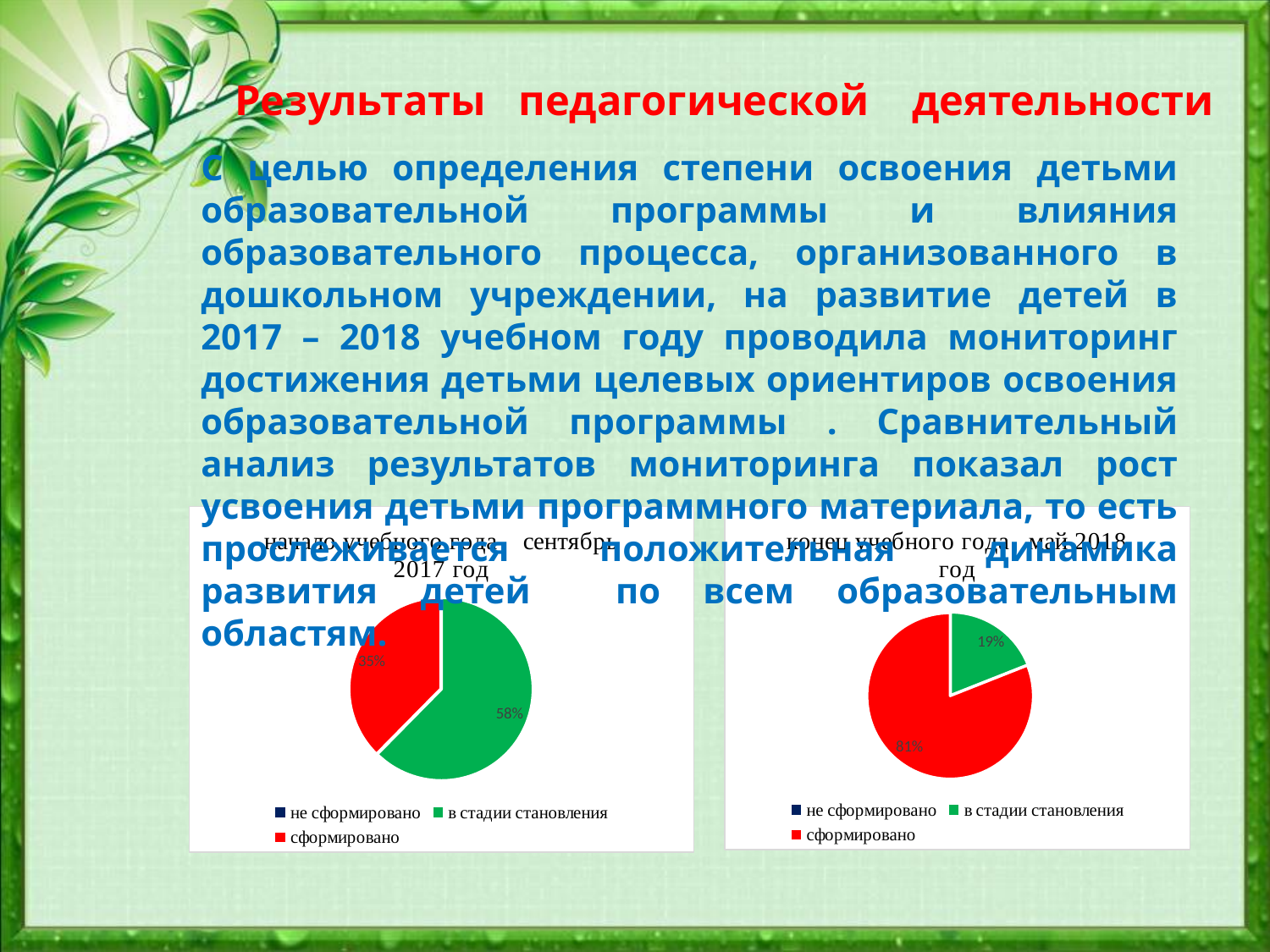
In the left pie chart (начало учебного года сентябрь 2017 год), which category has the largest slice? в стадии становления In the left pie chart (начало учебного года сентябрь 2017 год), what is the value for в стадии становления? 58% In the right pie chart (конец учебного года май 2018 год), what share of the pie is в стадии становления? 19% In the left pie chart (начало учебного года сентябрь 2017 год), what is the difference between в стадии становления and сформировано? 23 percentage points In the right pie chart (конец учебного года май 2018 год), what is the value for сформировано? 81% In the right pie chart (конец учебного года май 2018 год), which category has the largest slice? сформировано What kind of charts are shown on the slide? Pie charts How many entries does the legend of the right pie chart (конец учебного года май 2018 год) list? 3 In the left pie chart (начало учебного года сентябрь 2017 год), what is the value for сформировано? 35% In the right pie chart (конец учебного года май 2018 год), what colour represents сформировано? Red In the right pie chart (конец учебного года май 2018 год), what is the difference between сформировано and в стадии становления? 62 percentage points In the right pie chart (конец учебного года май 2018 год), which is larger: сформировано or в стадии становления? сформировано